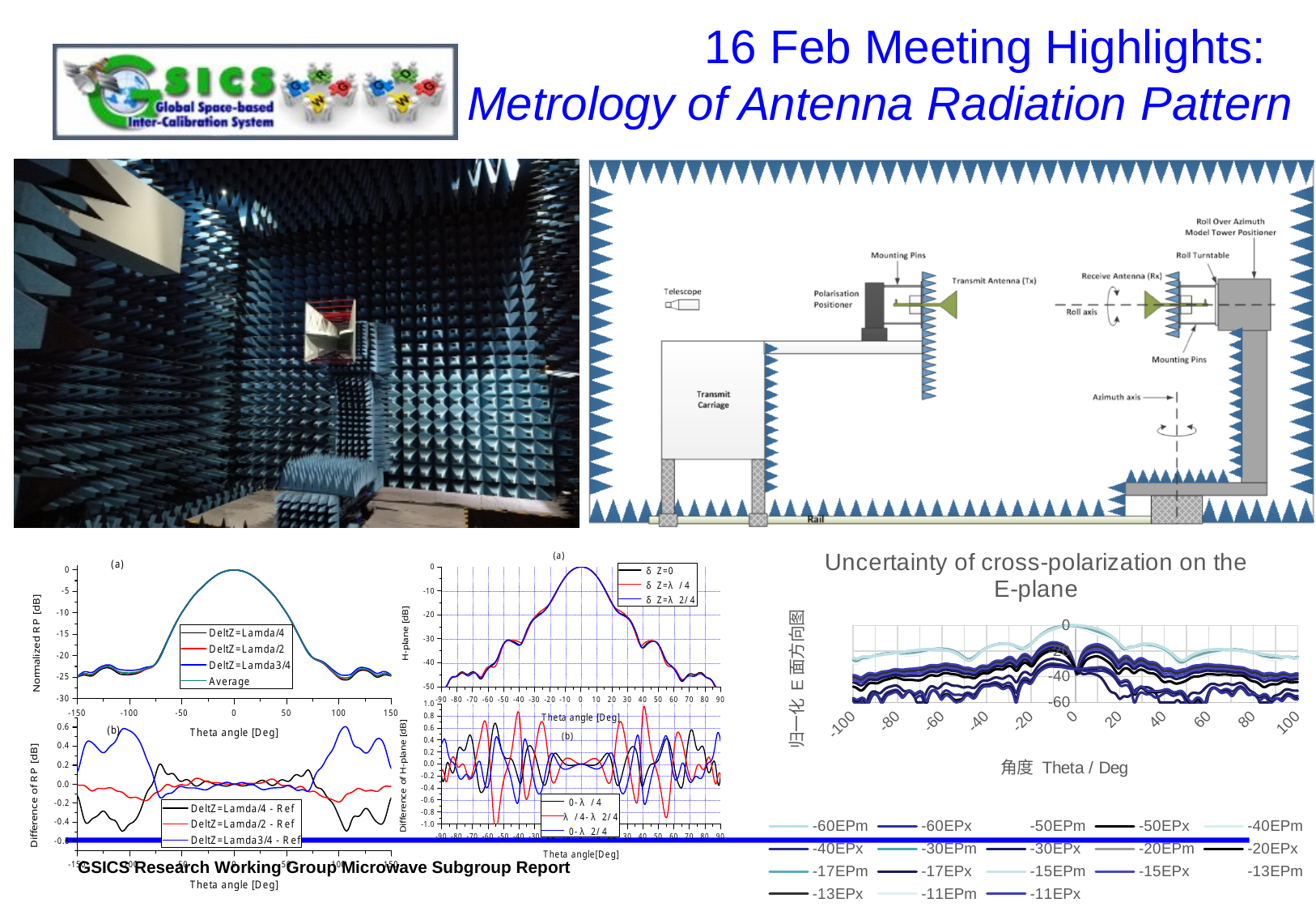
In the middle chart labelled (a) with y axis 'H-plane [dB]', is the value at a theta angle of -90 degrees greater or less than -30? less In the 'Uncertainty of cross-polarization on the E-plane' chart, what is the lowest tick value shown on the y axis? -60 What is the title of the chart at the bottom right of the slide? Uncertainty of cross-polarization on the E-plane In the bottom-left chart labelled (a) with y axis 'Normalized RP [dB]', is the value at a theta angle of 0 degrees greater or less than -5? greater In the middle chart labelled (a) with y axis 'H-plane [dB]', do the values rise or fall as the theta angle goes from -90 to 0 degrees? rise In the bottom-left chart labelled (a) with y axis 'Normalized RP [dB]', what is the x-axis label? Theta angle [Deg] In the middle chart labelled (a) with y axis 'H-plane [dB]', how many series does the legend list? 3 What kind of chart is the 'Uncertainty of cross-polarization on the E-plane' chart? line chart In the bottom-left chart labelled (a) with y axis 'Normalized RP [dB]', do the values rise or fall as the theta angle goes from 0 to 150 degrees? fall In the bottom-left chart labelled (a) with y axis 'Normalized RP [dB]', how many series does the legend list? 4 In the bottom-left chart labelled (a) with y axis 'Normalized RP [dB]', is the value at a theta angle of -150 degrees greater or less than -20? less In the 'Uncertainty of cross-polarization on the E-plane' chart, how many series does the legend list? 18